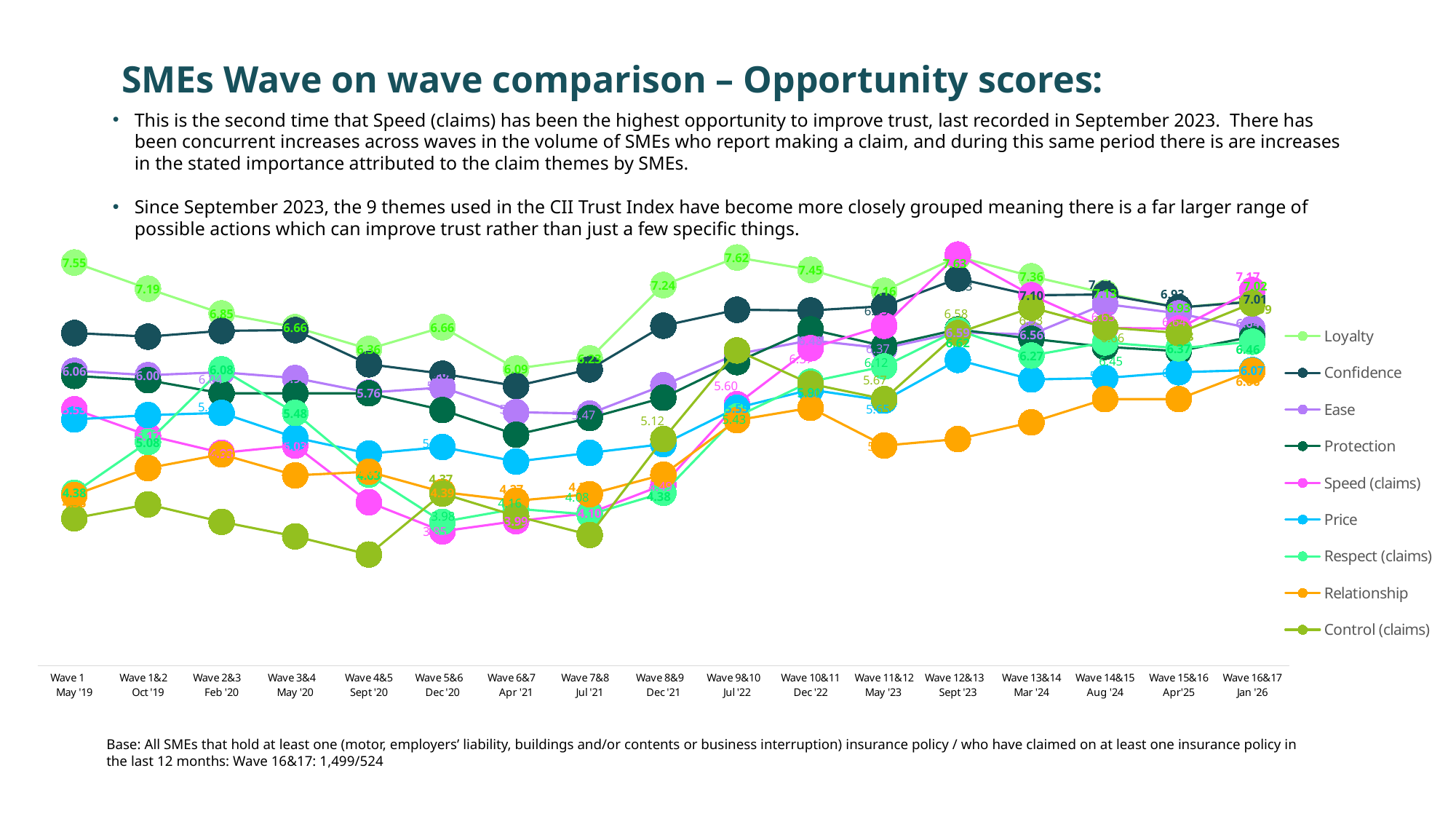
What is the difference between the Loyalty score at Wave 1 and at Wave 1&2? 0.36 What is the Confidence score at Wave 16&17 (Jan '26)? 7.01 What is the Loyalty score at Wave 1 (May '19)? 7.55 What is the Speed (claims) score at Wave 12&13 (Sept '23)? 7.66 How many waves are shown along the x axis? 17 What kind of chart is shown on the slide? line chart What is the Loyalty score at Wave 8&9 (Dec '21)? 7.24 Which series has the lowest score at Wave 4&5 (Sept '20)? Control (claims) What is the Loyalty score at Wave 9&10 (Jul '22)? 7.62 Does the Control (claims) line rise or fall from Wave 1 to Wave 4&5? fall How many series does the legend list? 9